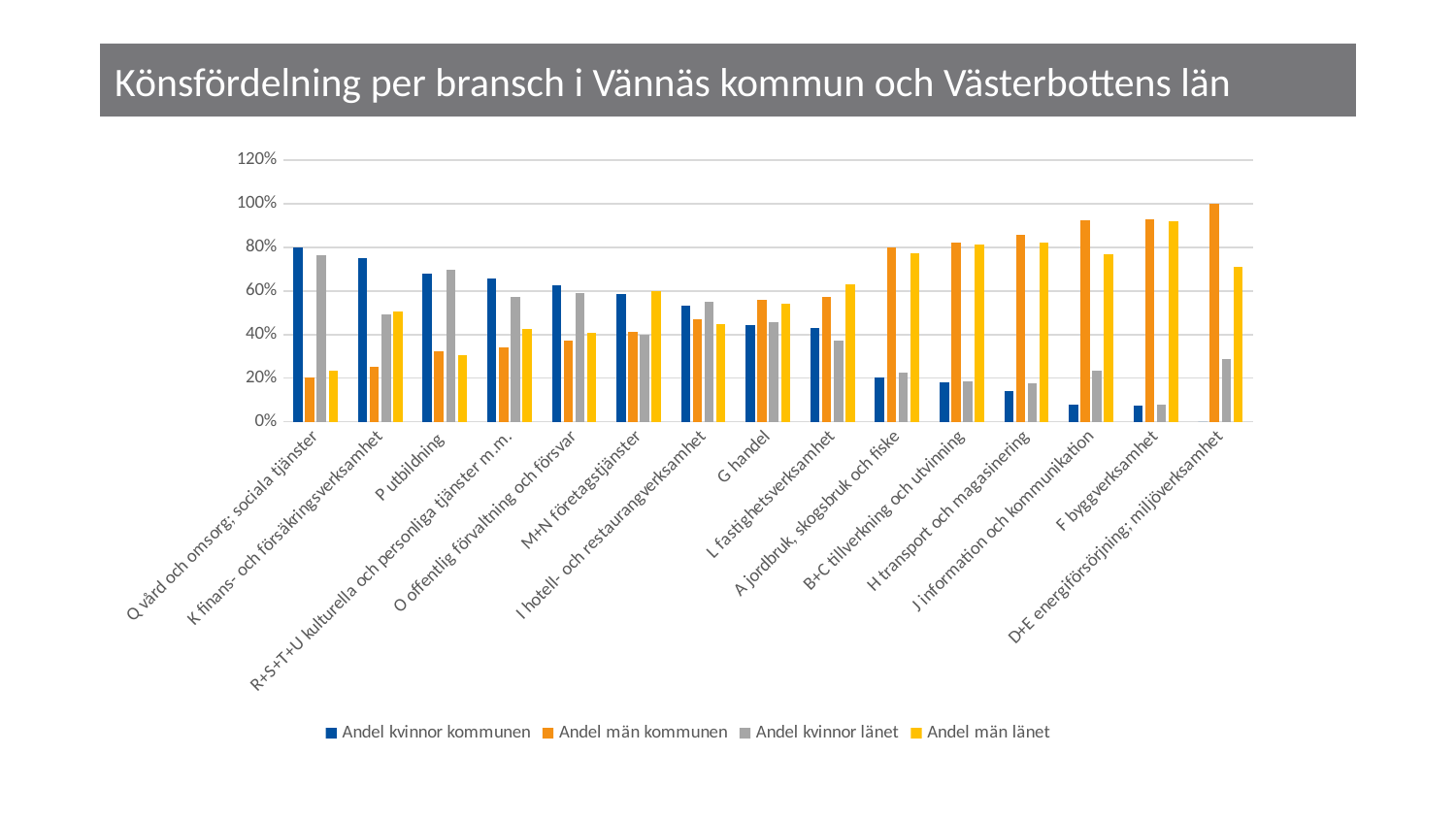
Does the Andel kvinnor kommunen series generally rise or fall from left to right along the x axis? Fall Is the value of Andel kvinnor kommunen for F byggverksamhet greater or less than 20%? less Which category has the highest value for Andel män kommunen? D+E energiförsörjning; miljöverksamhet Is the value of Andel män kommunen for J information och kommunikation greater or less than 80%? greater Is the value of Andel kvinnor länet for Q vård och omsorg; sociala tjänster greater or less than 60%? greater Which category has the highest value for Andel kvinnor kommunen? Q vård och omsorg; sociala tjänster How many series does the legend list? 4 For G handel, which is larger: Andel kvinnor kommunen or Andel män kommunen? Andel män kommunen What is the title of the chart? Könsfördelning per bransch i Vännäs kommun och Västerbottens län What is the value of Andel män kommunen for D+E energiförsörjning; miljöverksamhet? 100% What kind of chart is shown on the slide? Bar chart How many industry categories are shown on the x axis? 15